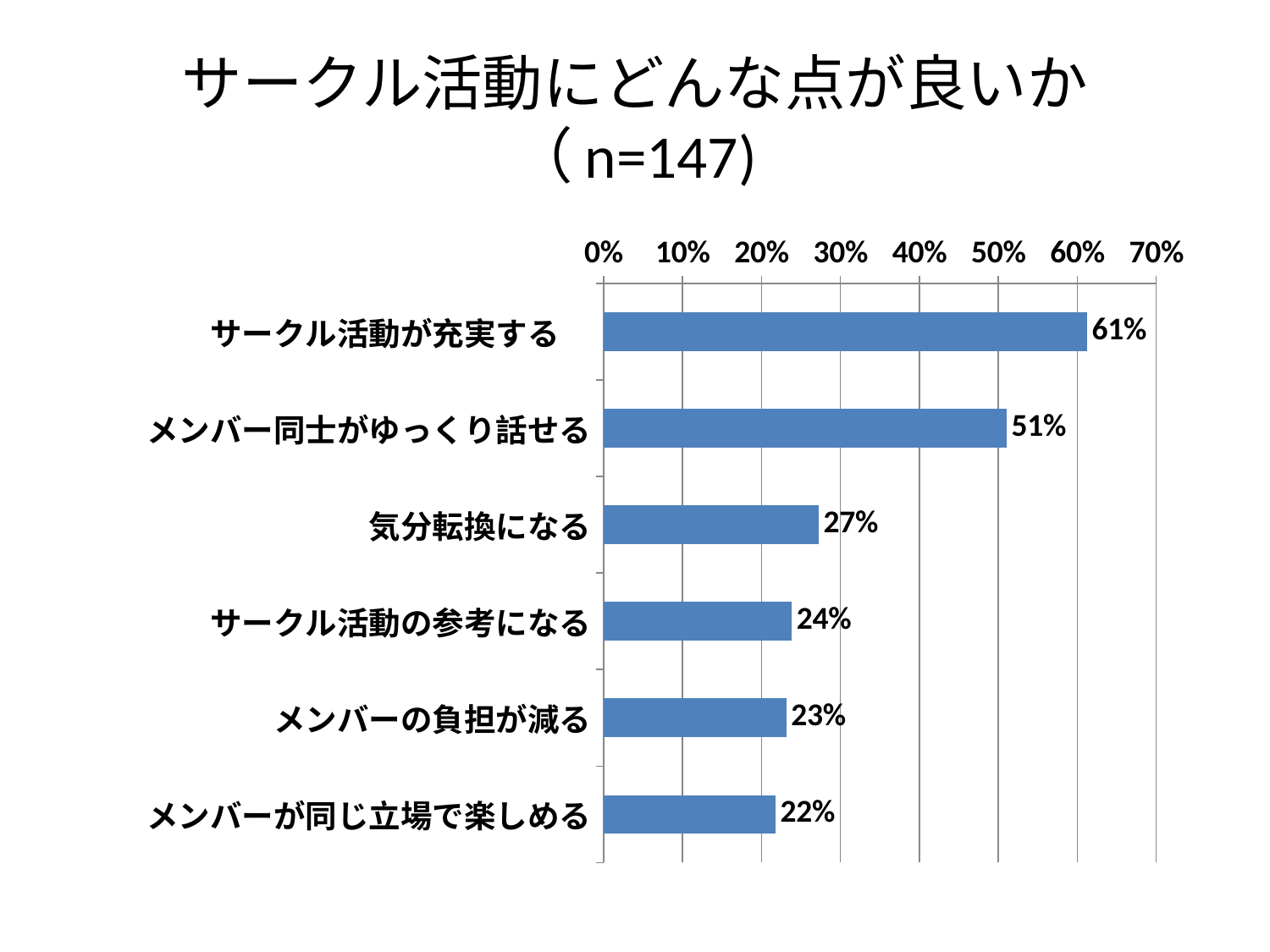
What is the value for サークル活動が充実する? 61% What is the difference between サークル活動が充実する and メンバー同士がゆっくり話せる? 10% What kind of chart is shown on the slide? bar chart Is the value for メンバーの負担が減る greater or less than 30%? less Which category has the highest value? サークル活動が充実する What is the sample size (n) shown in the chart title? 147 Which is larger, メンバー同士がゆっくり話せる or 気分転換になる? メンバー同士がゆっくり話せる What is the difference between 気分転換になる and サークル活動の参考になる? 3% What is the value for 気分転換になる? 27% Which category has the lowest value? メンバーが同じ立場で楽しめる How many categories are shown in the chart? 6 What is the value for メンバーが同じ立場で楽しめる? 22%